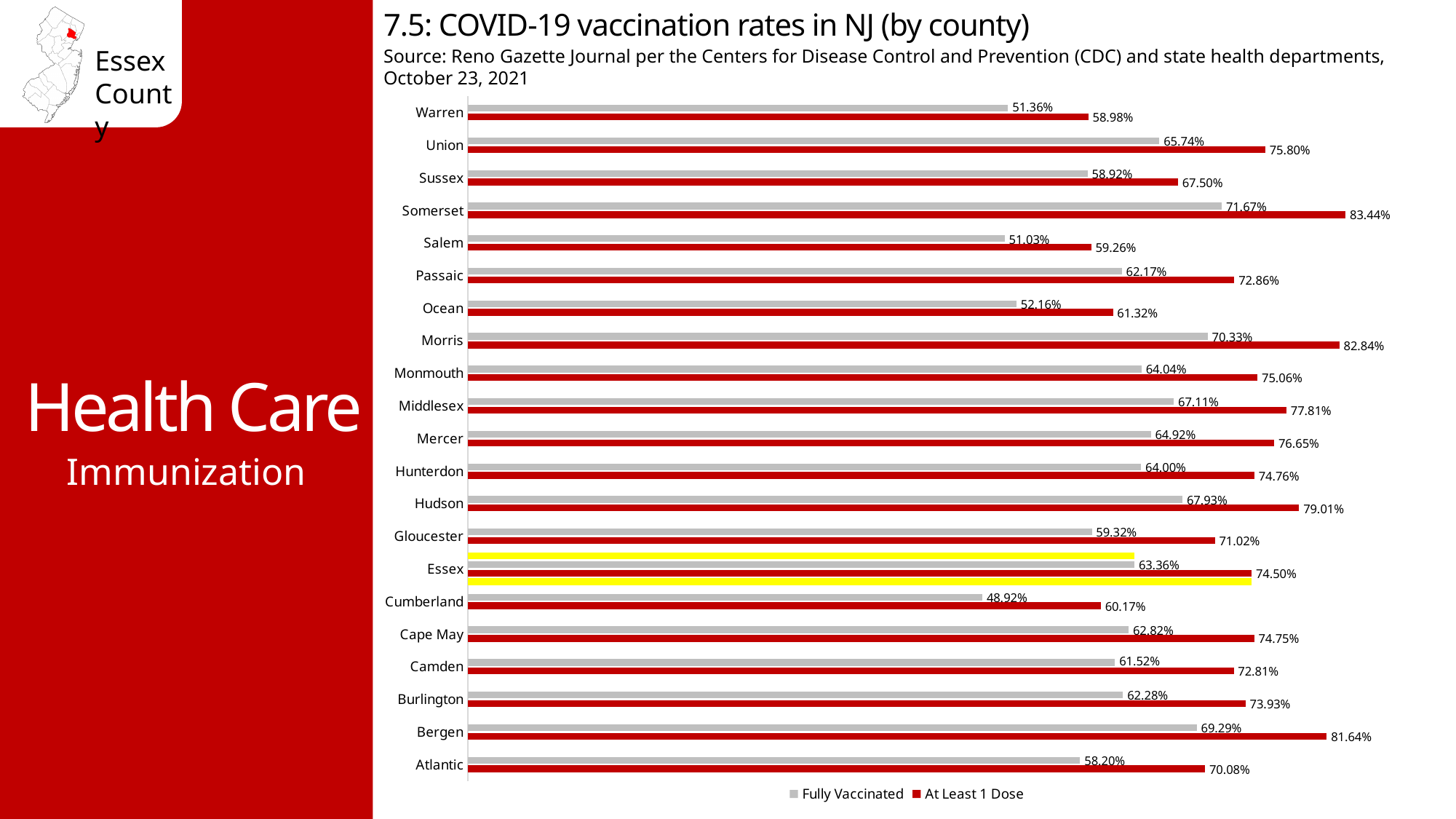
What is the At Least 1 Dose rate for Cumberland county? 60.17% Which county's bars are highlighted in yellow on the chart? Essex Which county has the lowest Fully Vaccinated rate? Cumberland How many series does the legend list? 2 Which county has the lowest At Least 1 Dose rate? Warren What type of chart is shown on the slide? Bar chart Which county has the highest Fully Vaccinated rate? Somerset What is the Fully Vaccinated rate for Essex county? 63.36% Which county has a higher Fully Vaccinated rate, Bergen or Hudson? Bergen What is the difference between the At Least 1 Dose rate and the Fully Vaccinated rate for Essex county? 11.14 percentage points How many counties are shown in the chart? 21 What is the At Least 1 Dose rate for Somerset county? 83.44%